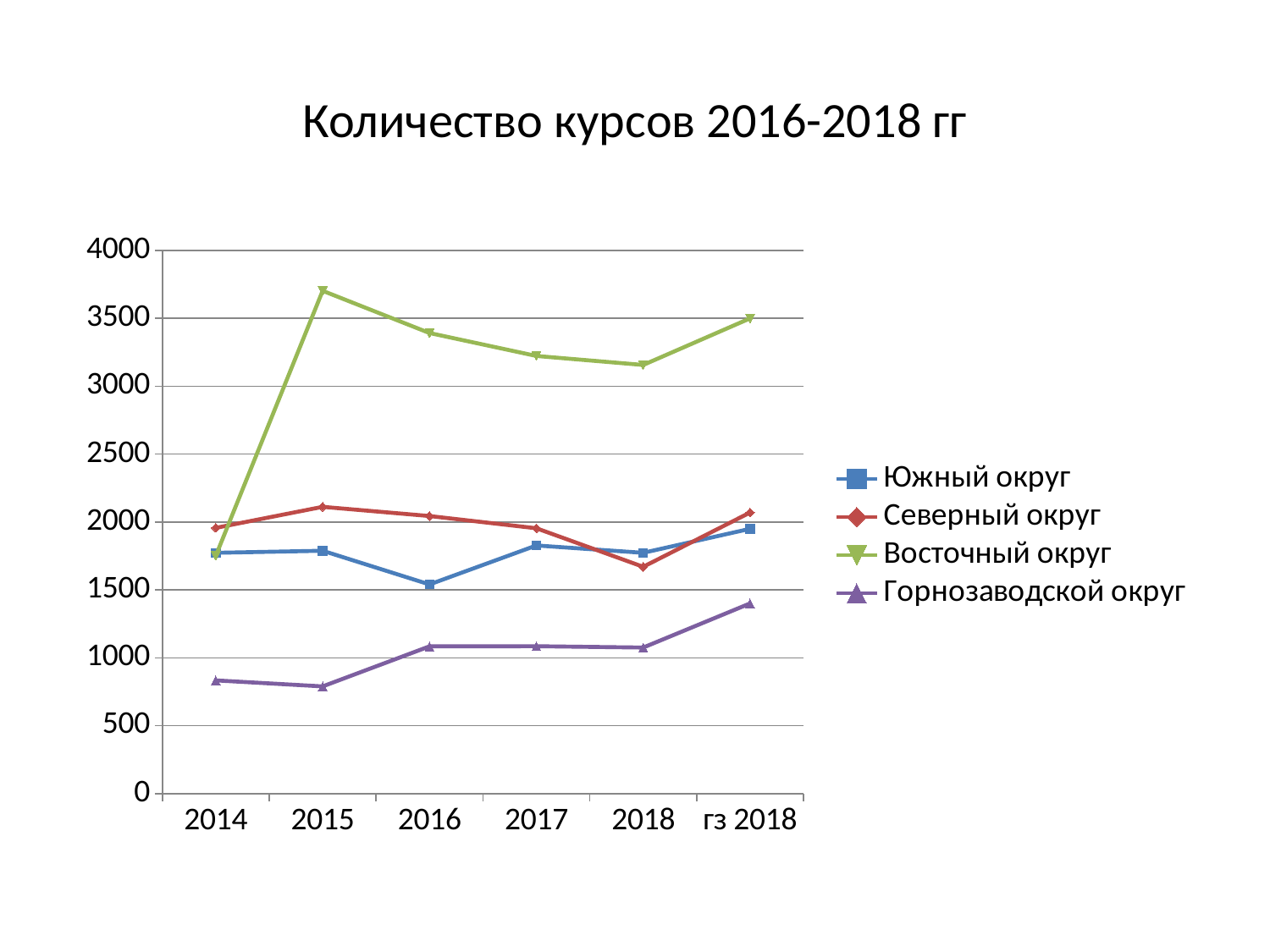
Does the value for Горнозаводской округ rise or fall overall from 2014 to гз 2018? rise Which series has the lowest value in 2014? Горнозаводской округ How many categories are shown on the x axis? 6 Is the value for Горнозаводской округ in 2014 greater or less than 1000? less Is the value for Северный округ in 2015 greater or less than 2000? greater In which category does Восточный округ have its lowest value? 2014 In 2018, which is larger: the value for Южный округ or the value for Северный округ? Южный округ Which series has the highest value in 2015? Восточный округ How many series does the legend list? 4 Is the value for Восточный округ in 2015 greater or less than 3500? greater What is the title of the chart? Количество курсов 2016-2018 гг What kind of chart is shown on the slide? line chart